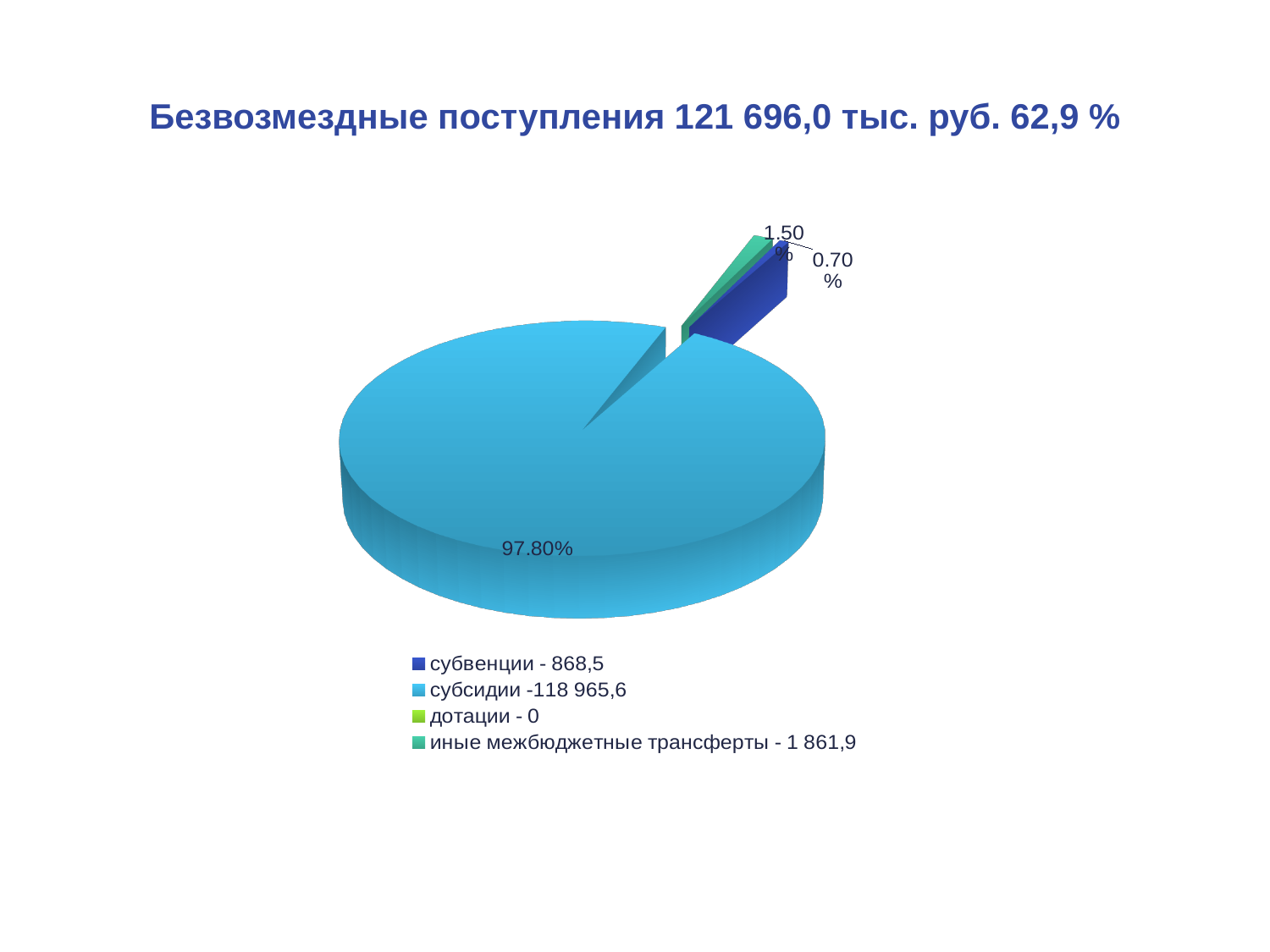
What is the title of the chart? Безвозмездные поступления 121 696,0 тыс. руб. 62,9 % Which category has the smallest value in the legend? дотации What value is given for дотации in the legend? 0 What percentage share is labelled for the субвенции slice? 0.70% What value is given for иные межбюджетные трансферты in the legend? 1 861,9 How many categories does the legend of the pie chart list? 4 What kind of chart is shown on the slide? pie chart What percentage share is labelled for the иные межбюджетные трансферты slice? 1.50% Which is larger, субвенции or иные межбюджетные трансферты? иные межбюджетные трансферты Which category has the largest slice of the pie? субсидии What value is given for субвенции in the legend? 868,5 What percentage share is labelled for the субсидии slice? 97.80%